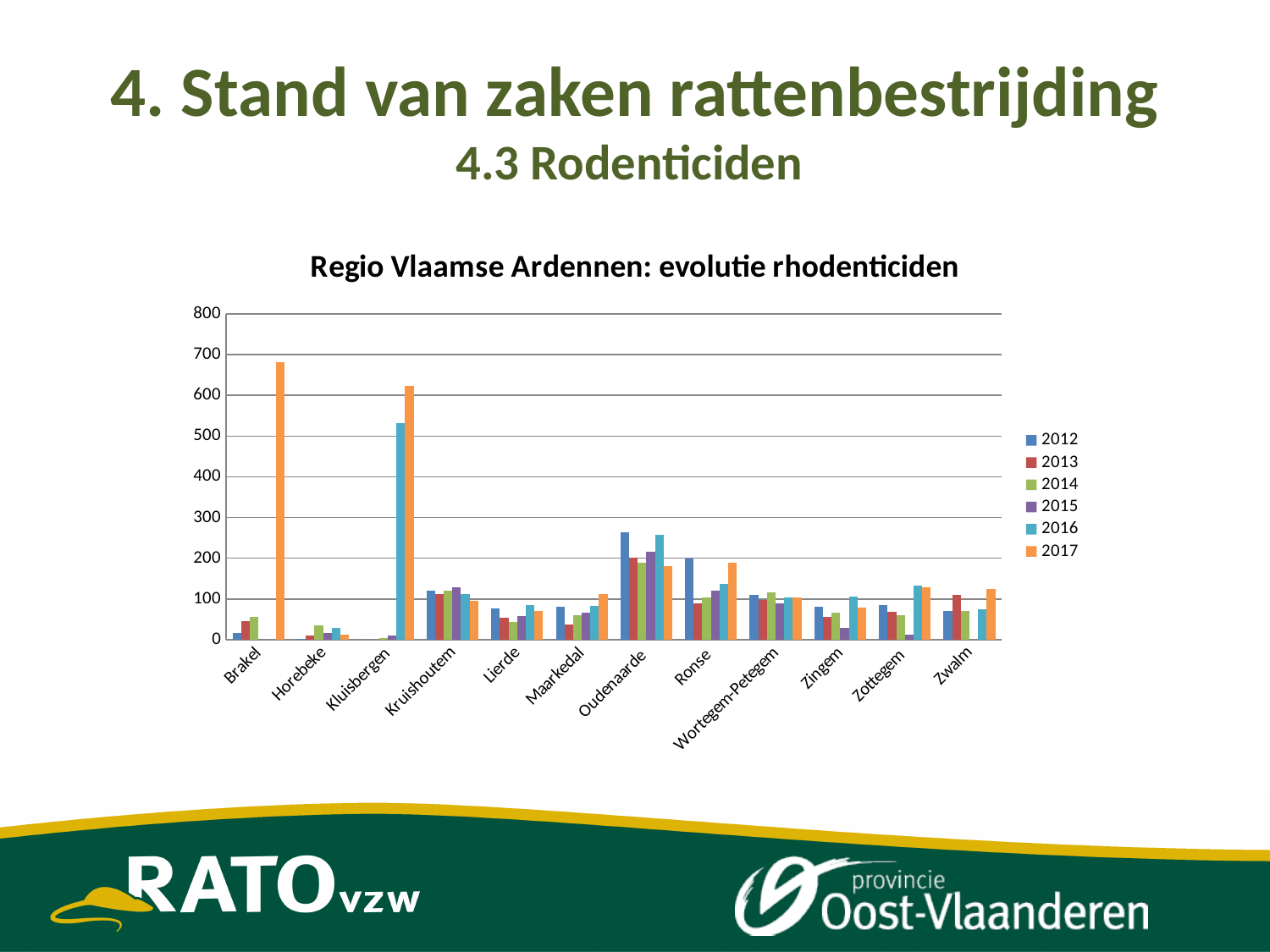
Which municipality has the highest value for 2012? Oudenaarde Is the 2017 value for Ronse greater or less than 200? less What is the title of the chart? Regio Vlaamse Ardennen: evolutie rhodenticiden How many series does the legend list? 6 Which municipality has the highest value for 2017? Brakel Is the 2017 value for Brakel greater or less than 600? greater What kind of chart is shown on the slide? bar chart For Oudenaarde, which is larger: the 2012 value or the 2017 value? 2012 Is the 2016 value for Kluisbergen greater or less than 500? greater Which municipality has the lowest value for 2017? Horebeke Which municipality has the highest value for 2016? Kluisbergen How many municipalities (categories) are shown on the x axis? 12